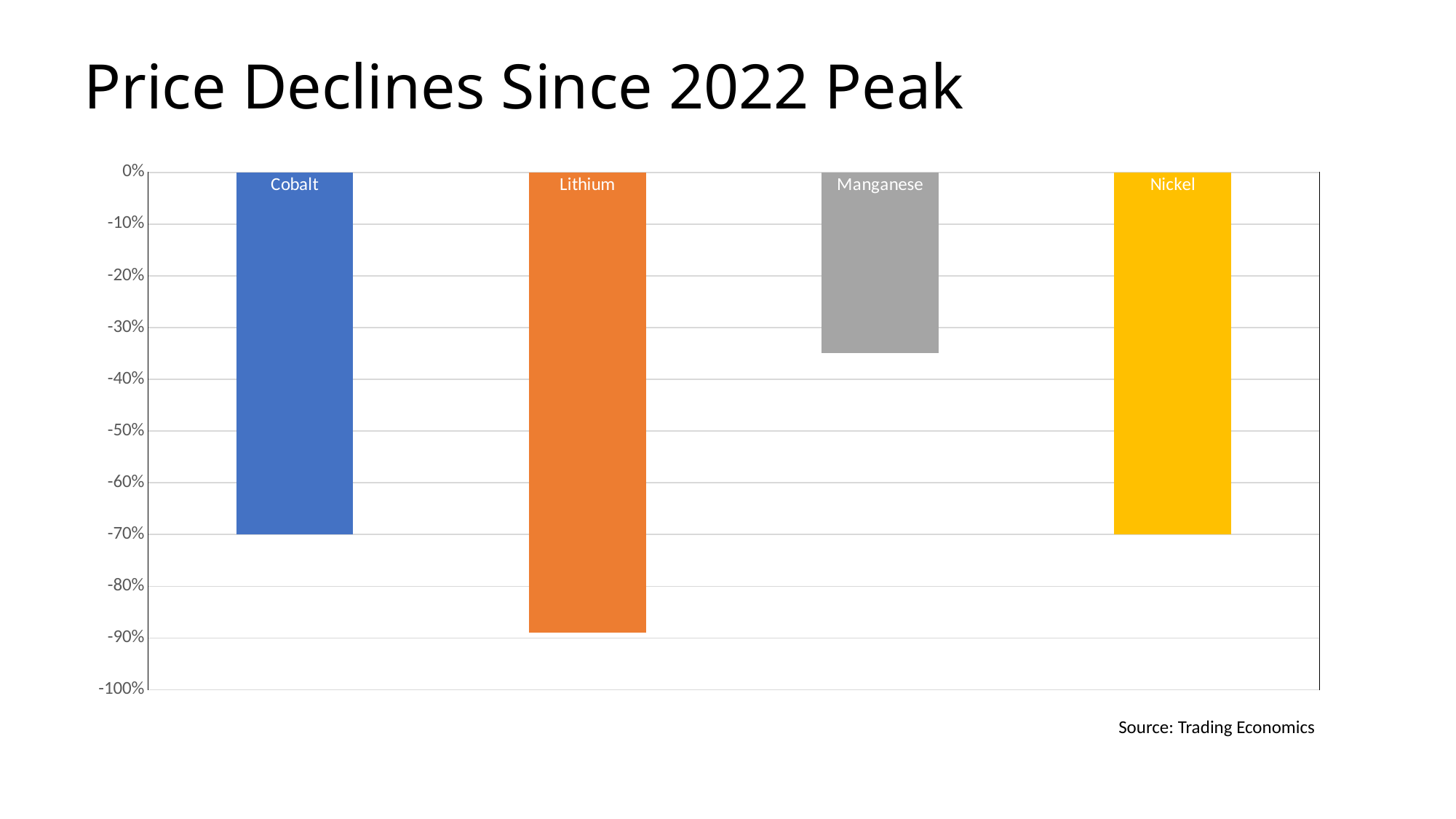
Is the value for Lithium greater or less than -80%? less What is the value for Cobalt? -70% What is the value for Nickel? -70% What kind of chart is shown on the slide? bar chart Which has the higher value, Manganese or Nickel? Manganese Which has the lower value, Lithium or Cobalt? Lithium Which category has the highest value (the smallest price decline)? Manganese What is the title of the slide? Price Declines Since 2022 Peak What colour is the Lithium bar? orange How many categories are shown in the chart? 4 Which category has the lowest value (the largest price decline)? Lithium Is the value for Manganese greater or less than -40%? greater